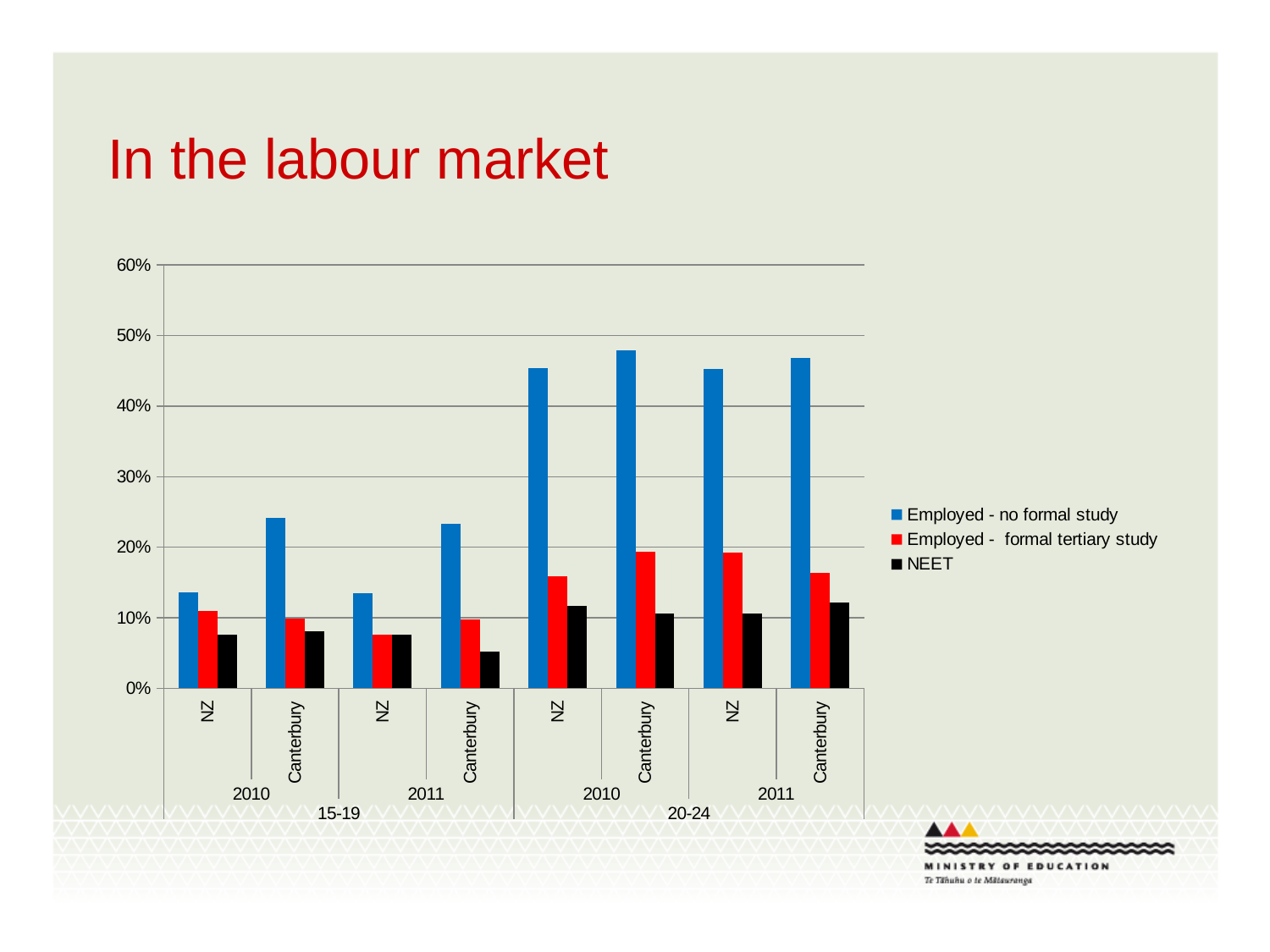
Is the 'Employed - no formal study' value for NZ in 2010 for the 20-24 age group greater or less than 40%? greater Is the NEET value for Canterbury in 2011 for the 15-19 age group greater or less than 10%? less Is the 'Employed - formal tertiary study' value for Canterbury in 2010 for the 20-24 age group greater or less than 10%? greater How many series does the legend list? 3 For the 15-19 age group in 2010, which has the larger 'Employed - no formal study' value, NZ or Canterbury? Canterbury What colour represents the NEET series in the chart? Black How many groups of bars (region-year combinations) are plotted along the x axis? 8 What kind of chart is shown on the slide? Bar chart Which group has the lowest NEET bar? Canterbury, 2011, 15-19 For NZ in 2010, which age group has the larger 'Employed - no formal study' value, 15-19 or 20-24? 20-24 For NZ in 2010 in the 20-24 age group, which is larger, 'Employed - formal tertiary study' or NEET? Employed - formal tertiary study